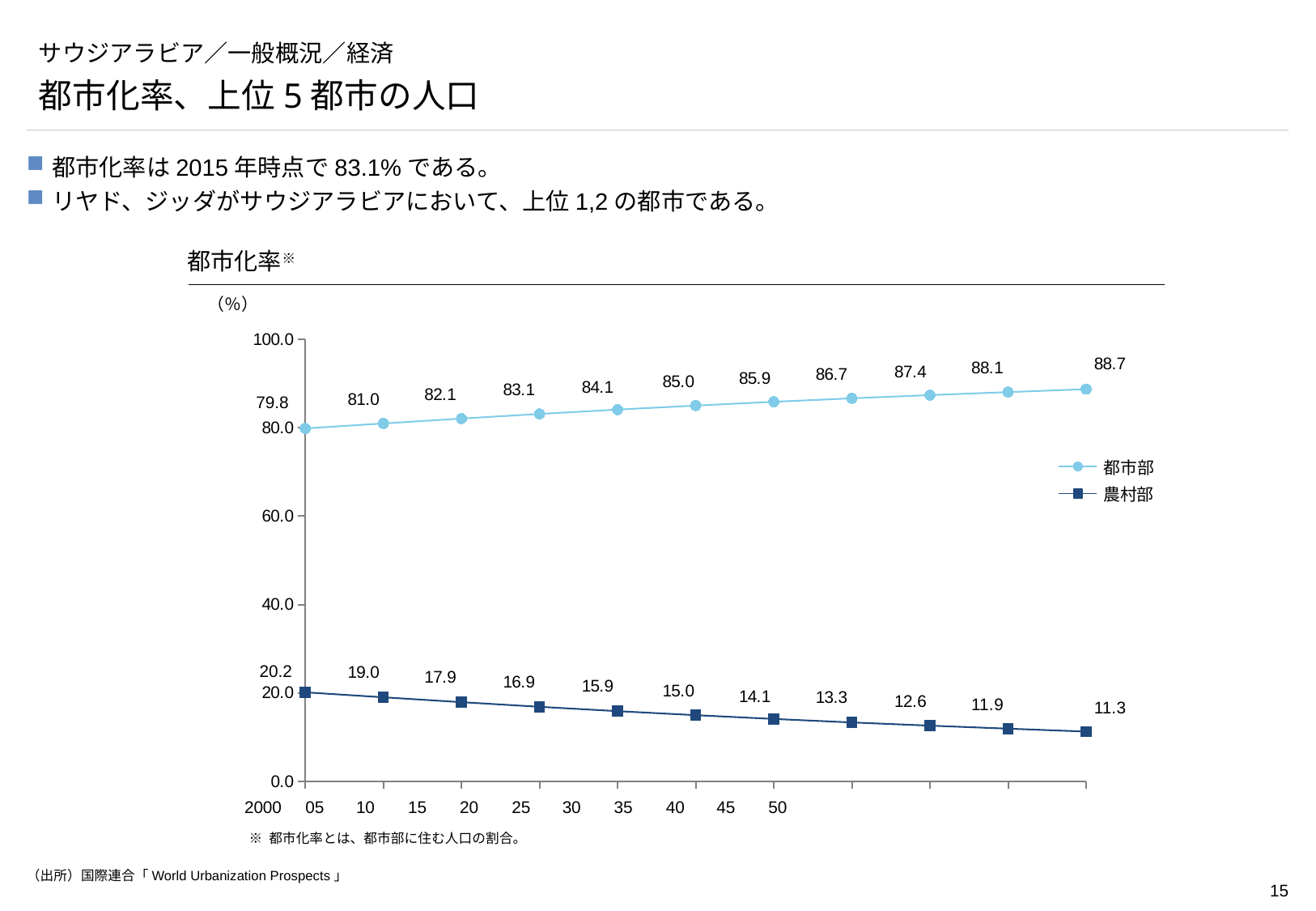
What is the value of 都市部 in 2015? 83.1 What is the value of the first data point of the 農村部 series? 20.2 Does the 都市部 series rise or fall along the x axis? rise What is the lowest value plotted for the 農村部 series? 11.3 What kind of chart is shown on the slide? line chart What unit is shown on the y axis of the chart? % What are the two series named in the legend? 都市部 and 農村部 How many series does the legend list? 2 What is the value of the last data point of the 都市部 series? 88.7 How many data points are plotted for each series? 11 What is the difference between the last and first values of the 都市部 series (88.7 and 79.8)? 8.9 What is the value of the last data point of the 農村部 series? 11.3